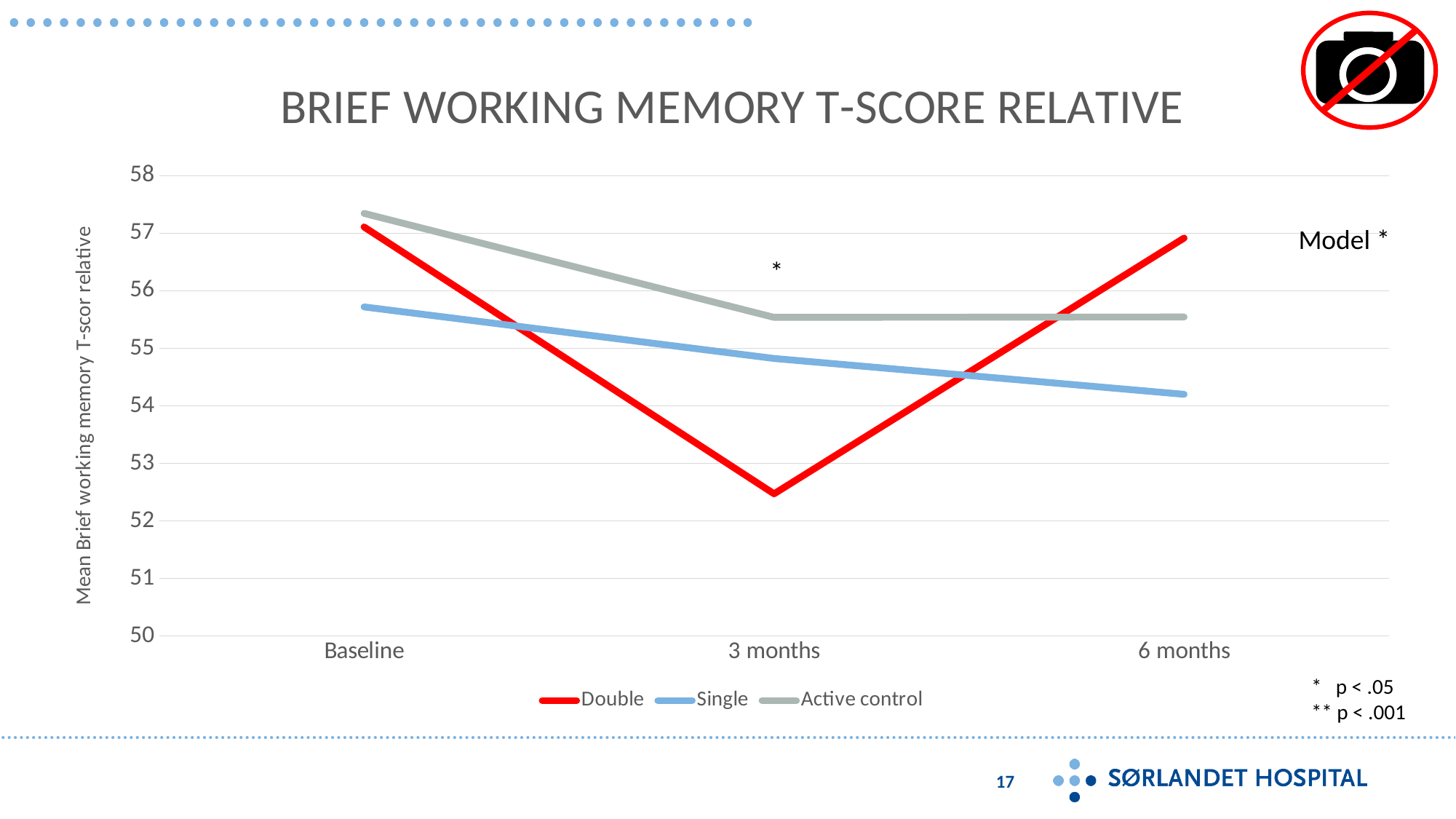
What colour is the line for the Double series? red Is the value for Single at 6 months greater or less than 55? less At 6 months, which is larger: the value for Double or the value for Single? Double Is the value for Double at 6 months greater or less than 56? greater Is the value for Double at 3 months greater or less than 53? less Which series has the highest value at 3 months? Active control How many time points are shown on the x axis? 3 What kind of chart is shown on the slide? line chart Which series has the lowest value at 3 months? Double Does the Single series rise or fall from Baseline to 6 months? fall Which series has the highest value at 6 months? Double How many series does the legend list? 3